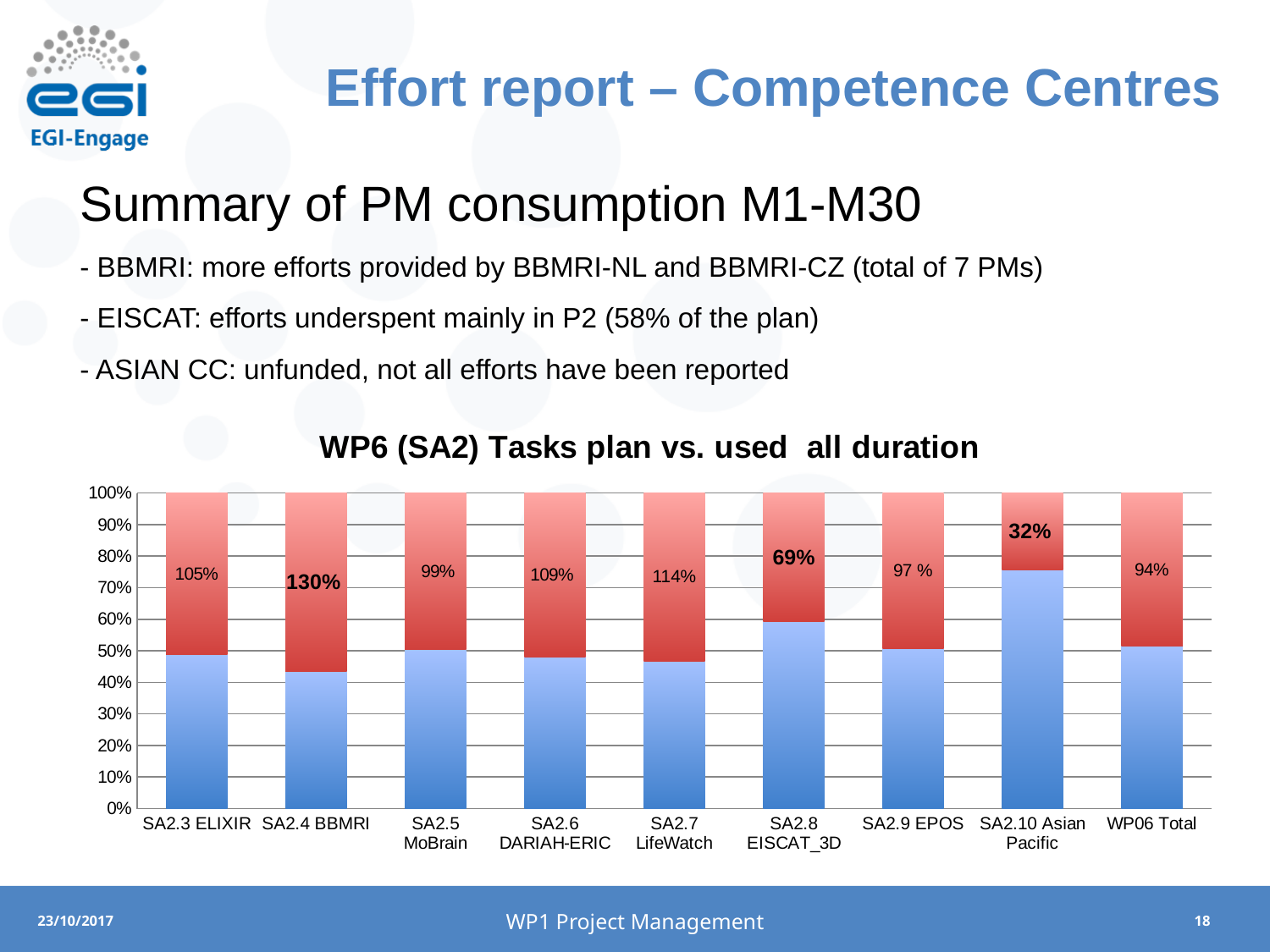
What percentage label is shown on the bar for SA2.8 EISCAT_3D? 69% What percentage label is shown on the bar for SA2.4 BBMRI? 130% Is the top of the blue segment for SA2.10 Asian Pacific greater or less than 70%? greater What is the title of the chart? WP6 (SA2) Tasks plan vs. used all duration What percentage label is shown on the bar for SA2.9 EPOS? 97 % What is the difference in percentage points between the labels for SA2.4 BBMRI and SA2.3 ELIXIR? 25 Which category has the highest percentage label? SA2.4 BBMRI What percentage label is shown on the bar for SA2.10 Asian Pacific? 32% Which category has the lowest percentage label? SA2.10 Asian Pacific Which has the larger percentage label, SA2.7 LifeWatch or SA2.6 DARIAH-ERIC? SA2.7 LifeWatch How many categories are shown on the x axis? 9 What percentage label is shown on the bar for WP06 Total? 94%